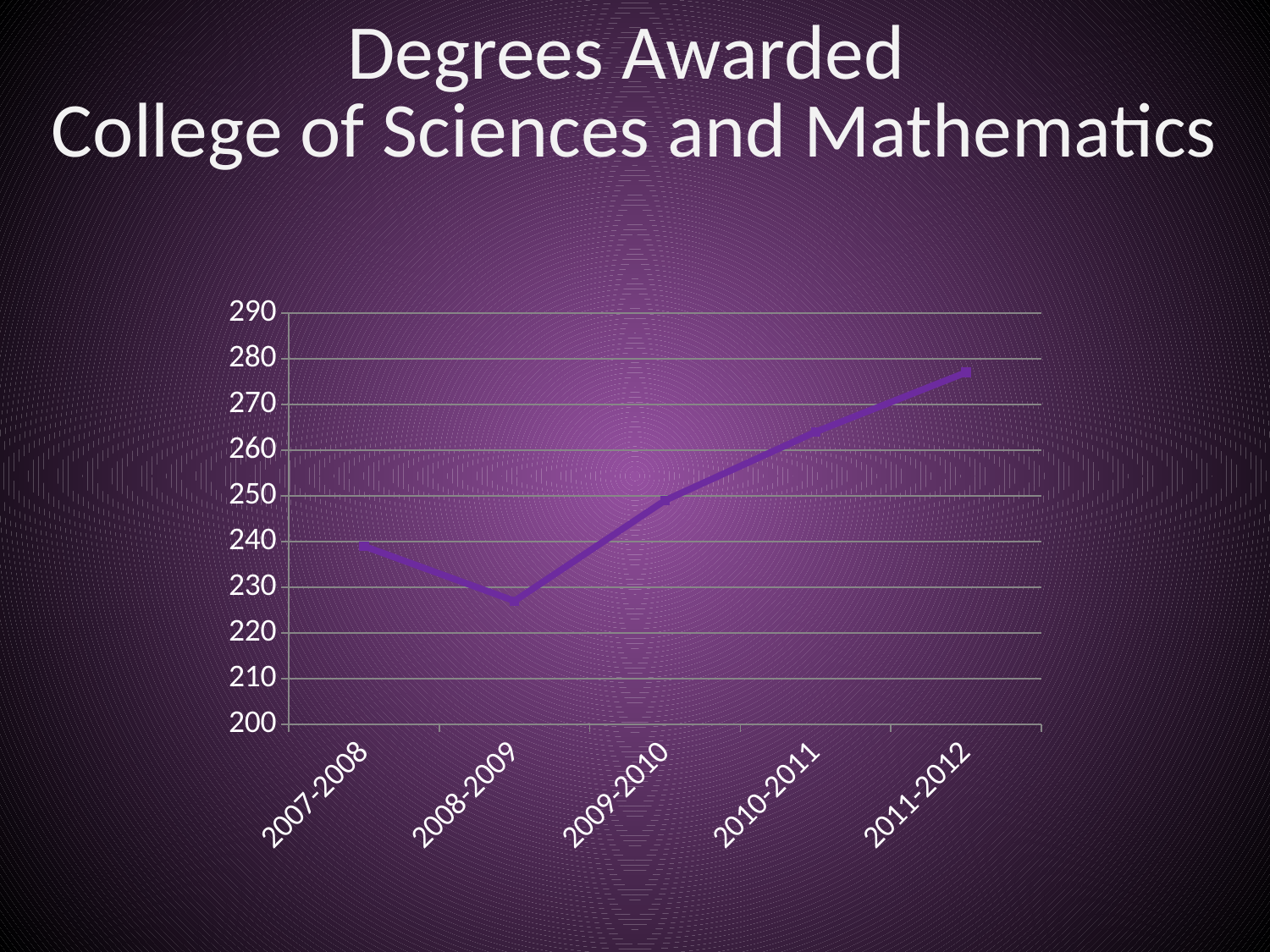
Do the values rise or fall from 2008-2009 to 2011-2012? rise Is the value for 2007-2008 greater or less than 230? greater Which academic year has the lowest number of degrees awarded? 2008-2009 Is the value for 2008-2009 greater or less than 230? less Is the value for 2009-2010 greater or less than 240? greater How many academic years are plotted on the x axis? 5 Which academic year has the highest number of degrees awarded? 2011-2012 What kind of chart is shown on the slide? line chart Which is larger, the value for 2007-2008 or the value for 2008-2009? 2007-2008 What is the title of the slide containing the chart? Degrees Awarded College of Sciences and Mathematics